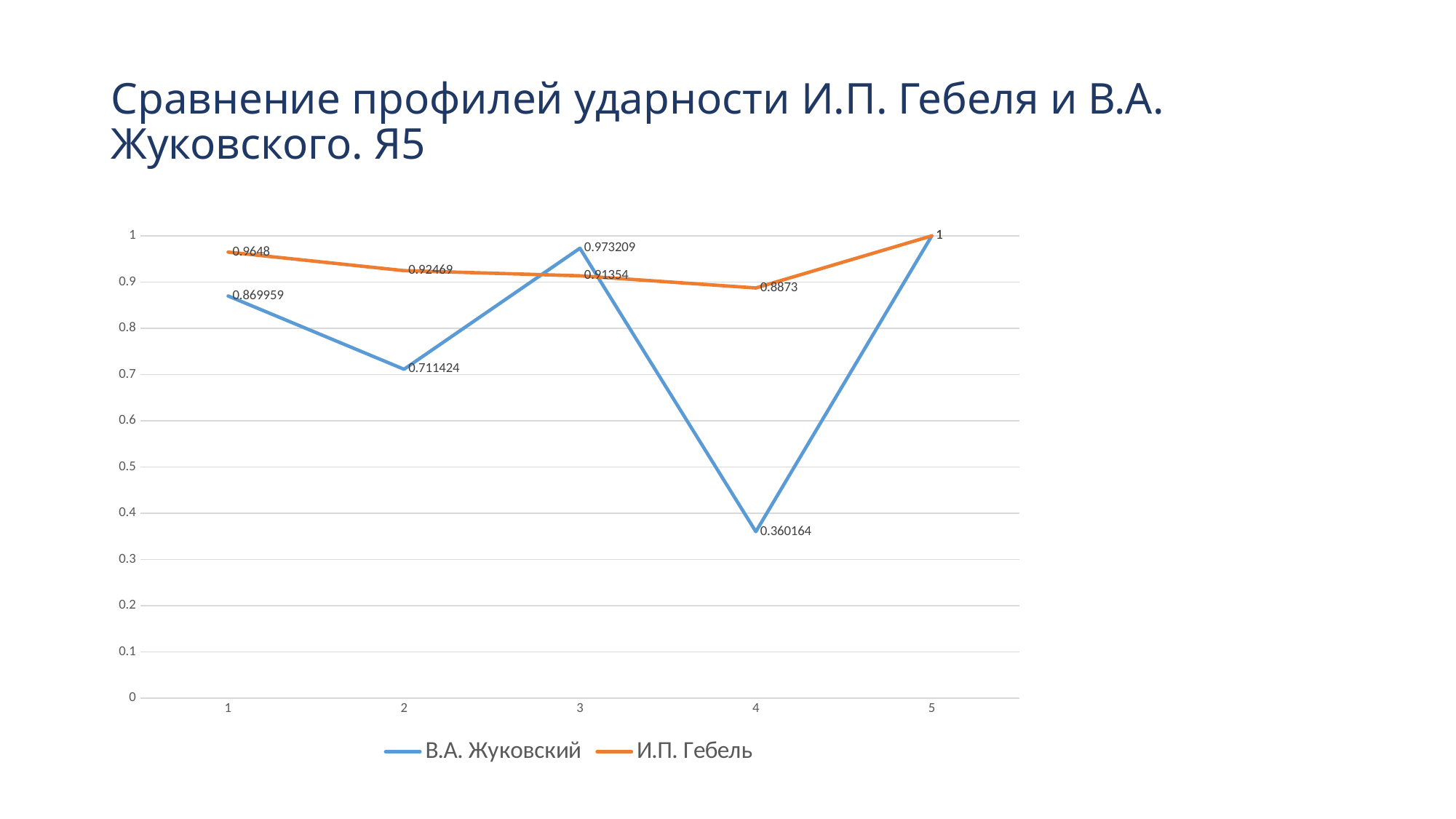
At which position is the value for И.П. Гебель lowest? 4 What is the value for И.П. Гебель at position 4? 0.8873 What is the value for В.А. Жуковский at position 2? 0.711424 At which position is the value for В.А. Жуковский lowest? 4 Does the value for И.П. Гебель rise or fall from position 1 to position 4? fall What type of chart is shown on the slide? line chart What is the value for И.П. Гебель at position 2? 0.92469 What is the value for В.А. Жуковский at position 4? 0.360164 What is the difference between the values of И.П. Гебель and В.А. Жуковский at position 4? 0.527136 How many series does the legend list? 2 How many positions are shown on the x axis? 5 Which series has the larger value at position 1, В.А. Жуковский or И.П. Гебель? И.П. Гебель